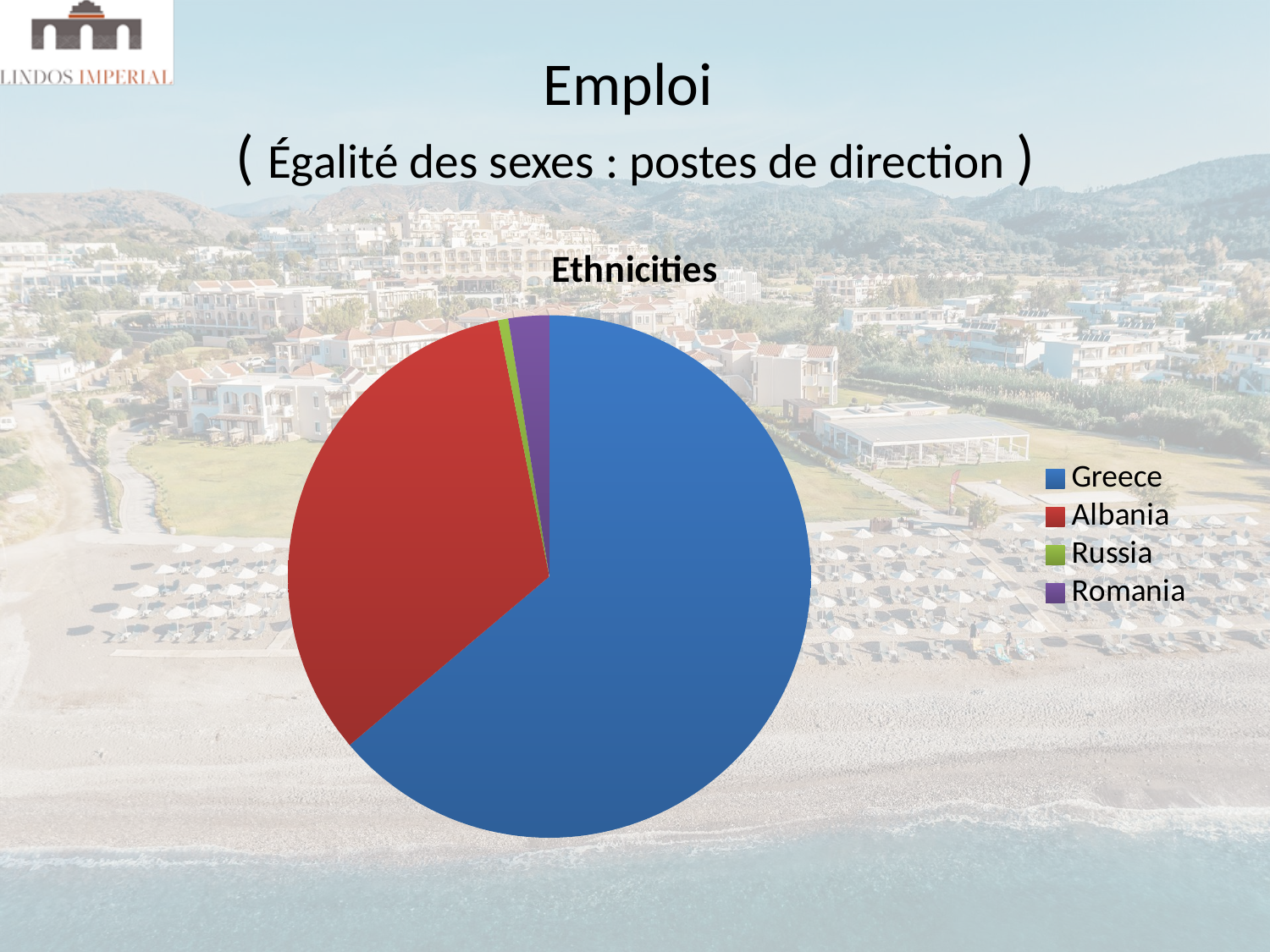
What kind of chart is shown on the slide? pie chart Which category has the second-largest slice of the pie? Albania What is the title of the chart? Ethnicities Which category has the largest slice of the pie? Greece Which slice is larger, Albania or Romania? Albania Which category is shown in red in the pie chart? Albania How many entries does the legend list? 4 Which slice is larger, Romania or Russia? Romania Which category has the smallest slice of the pie? Russia How many slices does the pie chart have? 4